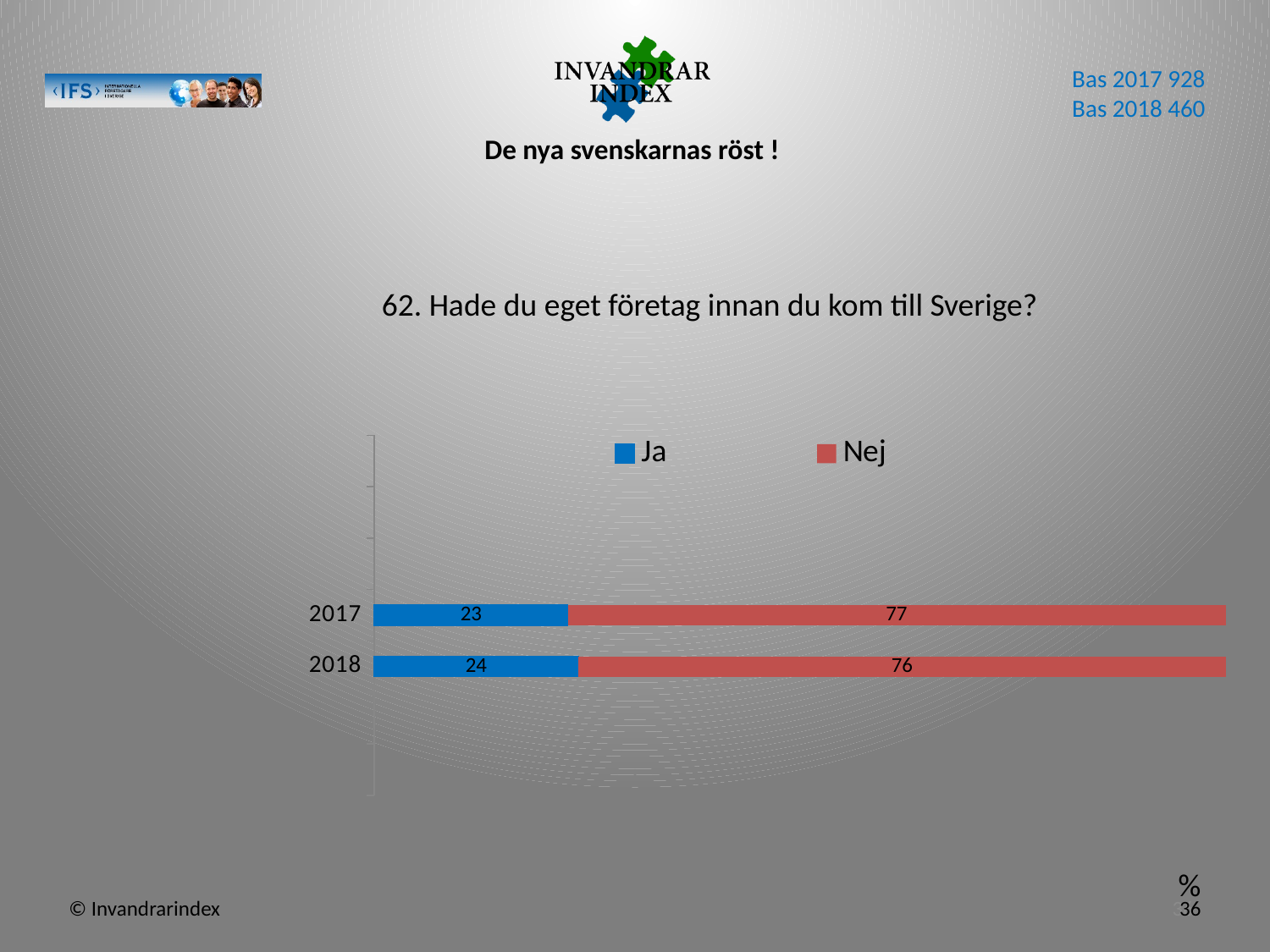
What is the value for "Ja" in 2018? 24 Which year has the higher value for "Nej"? 2017 What is the value for "Nej" in 2018? 76 What is the value for "Nej" in 2017? 77 What is the total of the stacked bar for 2018? 100 How many categories (years) are shown on the chart? 2 Which year has the higher value for "Ja"? 2018 What kind of chart is shown on the slide? Stacked bar chart Which colour represents "Nej" in the chart? Red What is the value for "Ja" in 2017? 23 How many series does the legend list? 2 What is the difference between the "Nej" and "Ja" values in 2017? 54